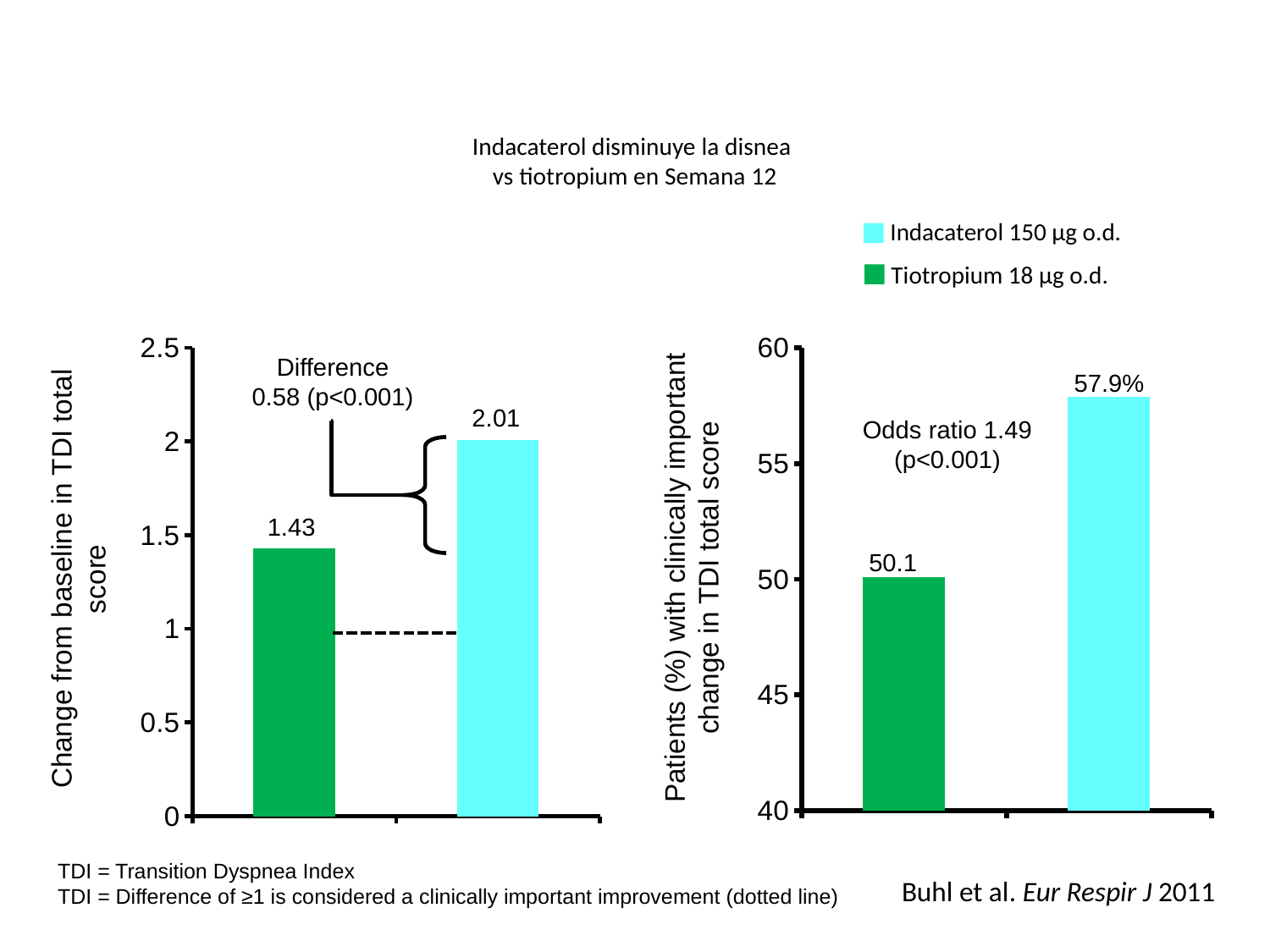
In the left chart, is the value for Indacaterol 150 µg o.d. greater or less than 1.5? greater In the left chart (change from baseline in TDI total score), what is the value for Tiotropium 18 µg o.d.? 1.43 In the left chart (change from baseline in TDI total score), what is the value for Indacaterol 150 µg o.d.? 2.01 How many bars are plotted in the right chart? 2 In the right chart (patients with clinically important change in TDI total score), what is the value for Indacaterol 150 µg o.d.? 57.9% In the right chart, is the value for Tiotropium 18 µg o.d. greater or less than 55? less In the right chart (patients with clinically important change in TDI total score), what is the value for Tiotropium 18 µg o.d.? 50.1 In the left chart, which treatment has the higher change from baseline in TDI total score? Indacaterol 150 µg o.d. In the right chart, which treatment has the lower percentage of patients with a clinically important change? Tiotropium 18 µg o.d. In the left chart, what is the difference between the Indacaterol and Tiotropium values? 0.58 How many series does the legend list? 2 What type of chart is the left chart? Bar chart